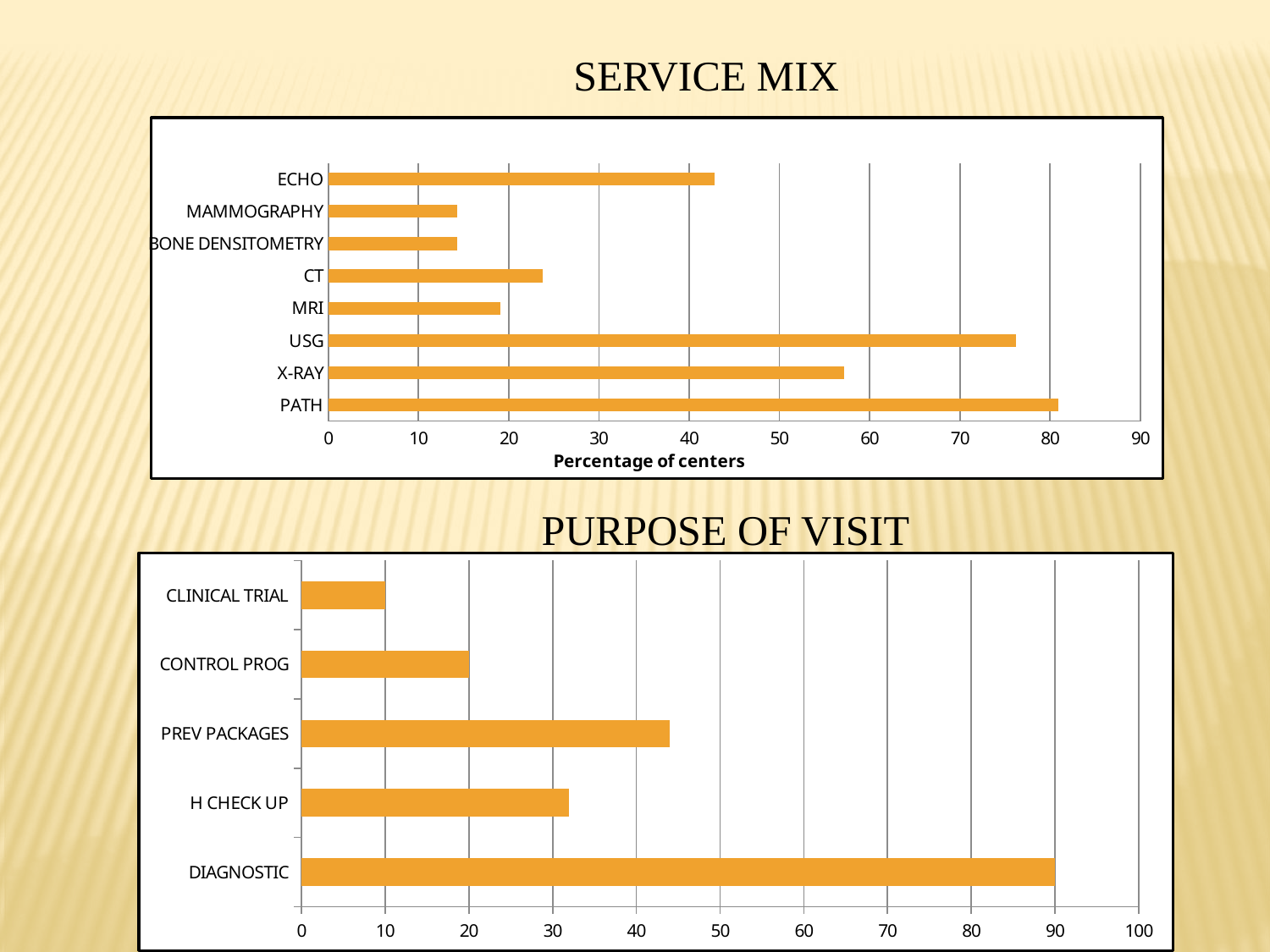
What type of chart is the PURPOSE OF VISIT chart? bar chart In the PURPOSE OF VISIT chart, which purpose has the lowest value? CLINICAL TRIAL In the PURPOSE OF VISIT chart, which purpose has the highest value? DIAGNOSTIC In the SERVICE MIX chart, is the value for USG greater or less than 70? greater In the PURPOSE OF VISIT chart, which is larger, the value for H CHECK UP or the value for CONTROL PROG? H CHECK UP In the SERVICE MIX chart, which service has the highest percentage of centers? PATH How many services are listed in the SERVICE MIX chart? 8 What is the x-axis title of the SERVICE MIX chart? Percentage of centers In the PURPOSE OF VISIT chart, is the value for PREV PACKAGES greater or less than 40? greater In the SERVICE MIX chart, which is larger, the value for X-RAY or the value for CT? X-RAY In the SERVICE MIX chart, is the value for ECHO greater or less than 40? greater